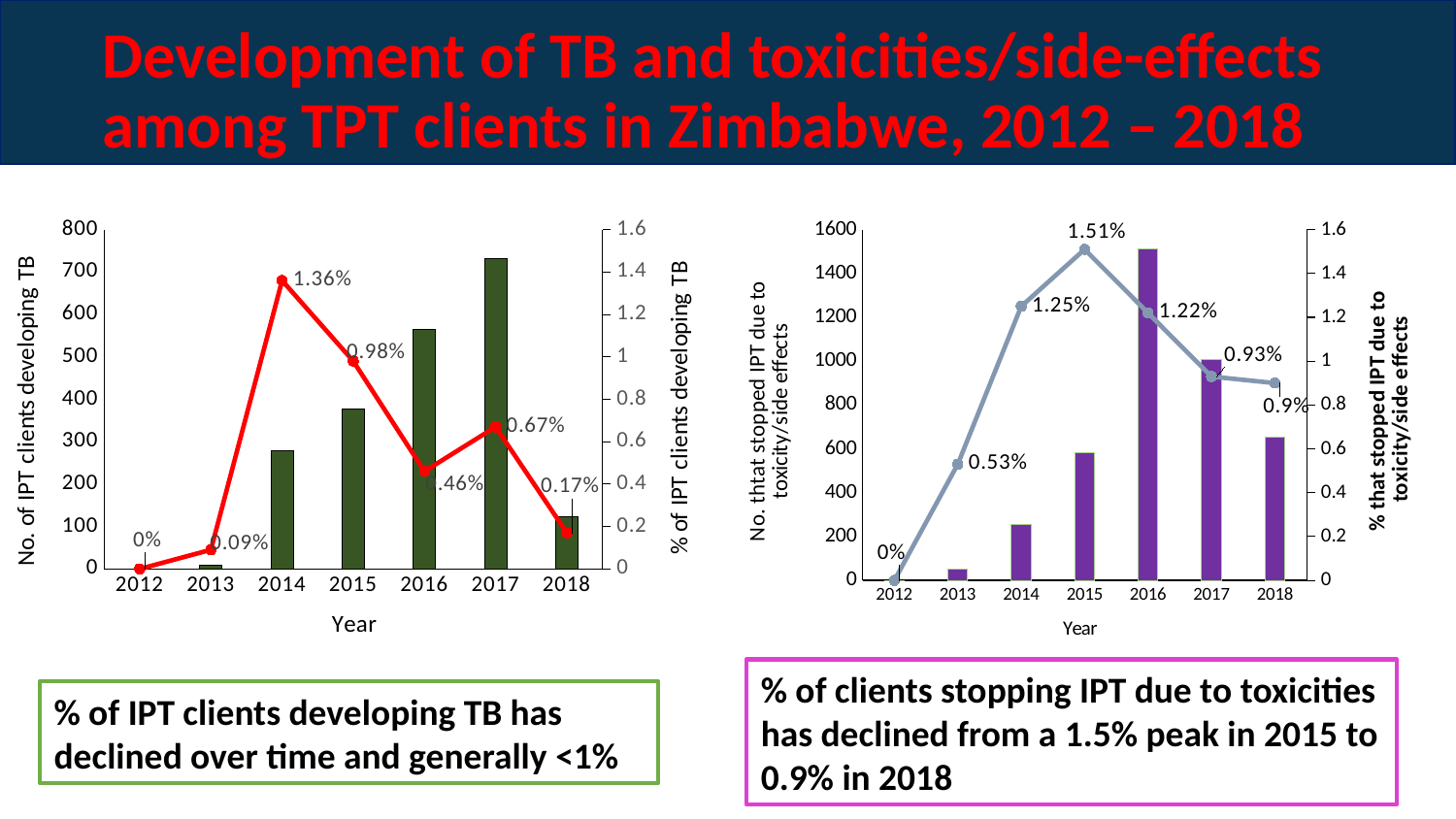
In the right chart (No. that stopped IPT due to toxicity/side effects), what is the percentage that stopped IPT due to toxicity/side effects in 2015? 1.51% In the right chart (No. that stopped IPT due to toxicity/side effects), which is larger: the percentage in 2014 or the percentage in 2017? 2014 How many years are shown on the x axis of the right chart (No. that stopped IPT due to toxicity/side effects)? 7 In the right chart (No. that stopped IPT due to toxicity/side effects), what is the percentage that stopped IPT due to toxicity/side effects in 2013? 0.53% In the right chart (No. that stopped IPT due to toxicity/side effects), is the number that stopped IPT in 2017 greater or less than 800? greater In the left chart (No. of IPT clients developing TB), what is the difference between the percentage in 2014 and the percentage in 2015? 0.38% In the right chart (No. that stopped IPT due to toxicity/side effects), which year has the tallest bar for number that stopped IPT? 2016 In the left chart (No. of IPT clients developing TB), what is the percentage of IPT clients developing TB in 2018? 0.17% In the left chart (No. of IPT clients developing TB), which year has the tallest bar for number of IPT clients developing TB? 2017 In the left chart (No. of IPT clients developing TB), is the number of IPT clients developing TB in 2016 greater or less than 500? greater In the left chart (No. of IPT clients developing TB), which year has the highest percentage of IPT clients developing TB? 2014 In the left chart (No. of IPT clients developing TB), what is the percentage of IPT clients developing TB in 2014? 1.36%